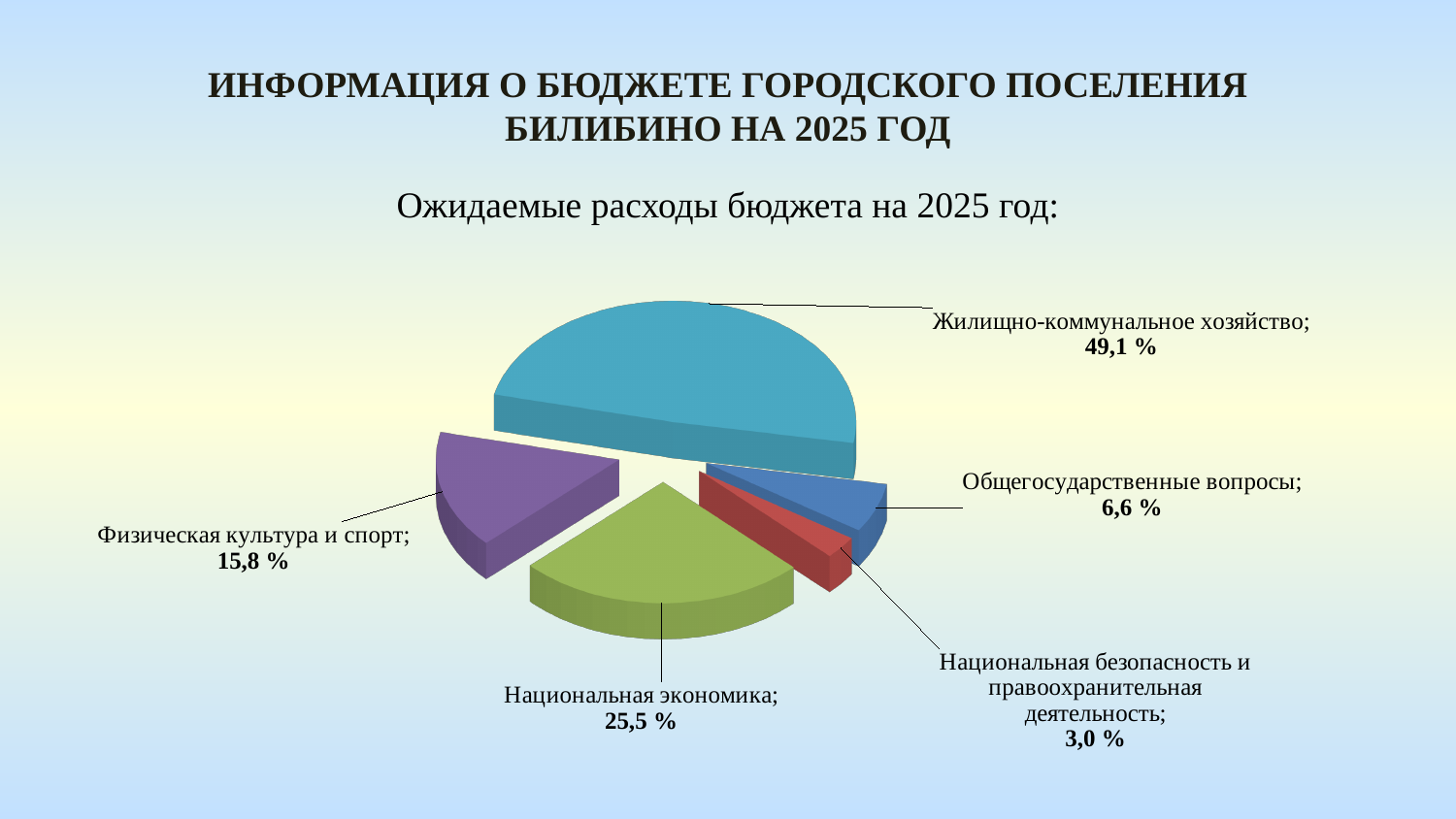
Which is larger: the share for Общегосударственные вопросы or the share for Физическая культура и спорт? Физическая культура и спорт What percentage is shown for Общегосударственные вопросы? 6,6 % What percentage is shown for Национальная экономика? 25,5 % Which category has the smallest share of the pie? Национальная безопасность и правоохранительная деятельность What percentage is shown for Физическая культура и спорт? 15,8 % What percentage is shown for Национальная безопасность и правоохранительная деятельность? 3,0 % How many slices does the pie chart have? 5 Which category has the largest share of the pie? Жилищно-коммунальное хозяйство What kind of chart is shown on the slide? Pie chart What is the difference in percentage points between Национальная экономика and Физическая культура и спорт? 9,7 What share of the expected 2025 budget expenditure goes to Жилищно-коммунальное хозяйство? 49,1 % What colour is the slice for Национальная экономика? Green